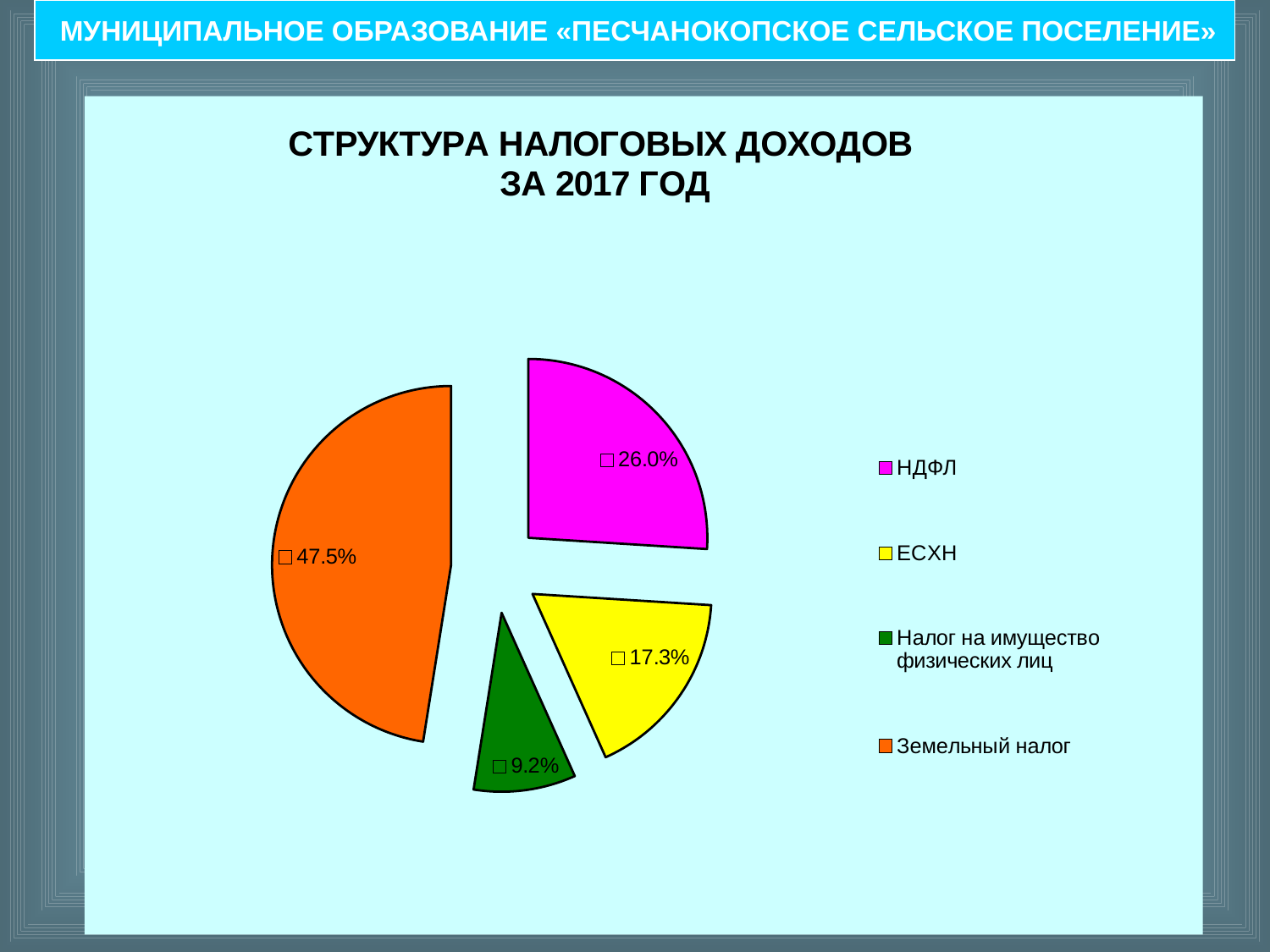
Which is larger, the share of НДФЛ or the share of ЕСХН? НДФЛ What is the share of НДФЛ in the pie chart? 26.0% What is the difference in percentage points between Земельный налог and НДФЛ? 21.5 Which category has the largest share of the pie? Земельный налог What is the title of the chart? СТРУКТУРА НАЛОГОВЫХ ДОХОДОВ ЗА 2017 ГОД Which category has the smallest share of the pie? Налог на имущество физических лиц What is the share of Налог на имущество физических лиц in the pie chart? 9.2% How many categories does the pie chart show? 4 What is the share of Земельный налог in the pie chart? 47.5% What colour is the slice for ЕСХН? yellow What kind of chart is shown on the slide? pie chart What is the share of ЕСХН in the pie chart? 17.3%